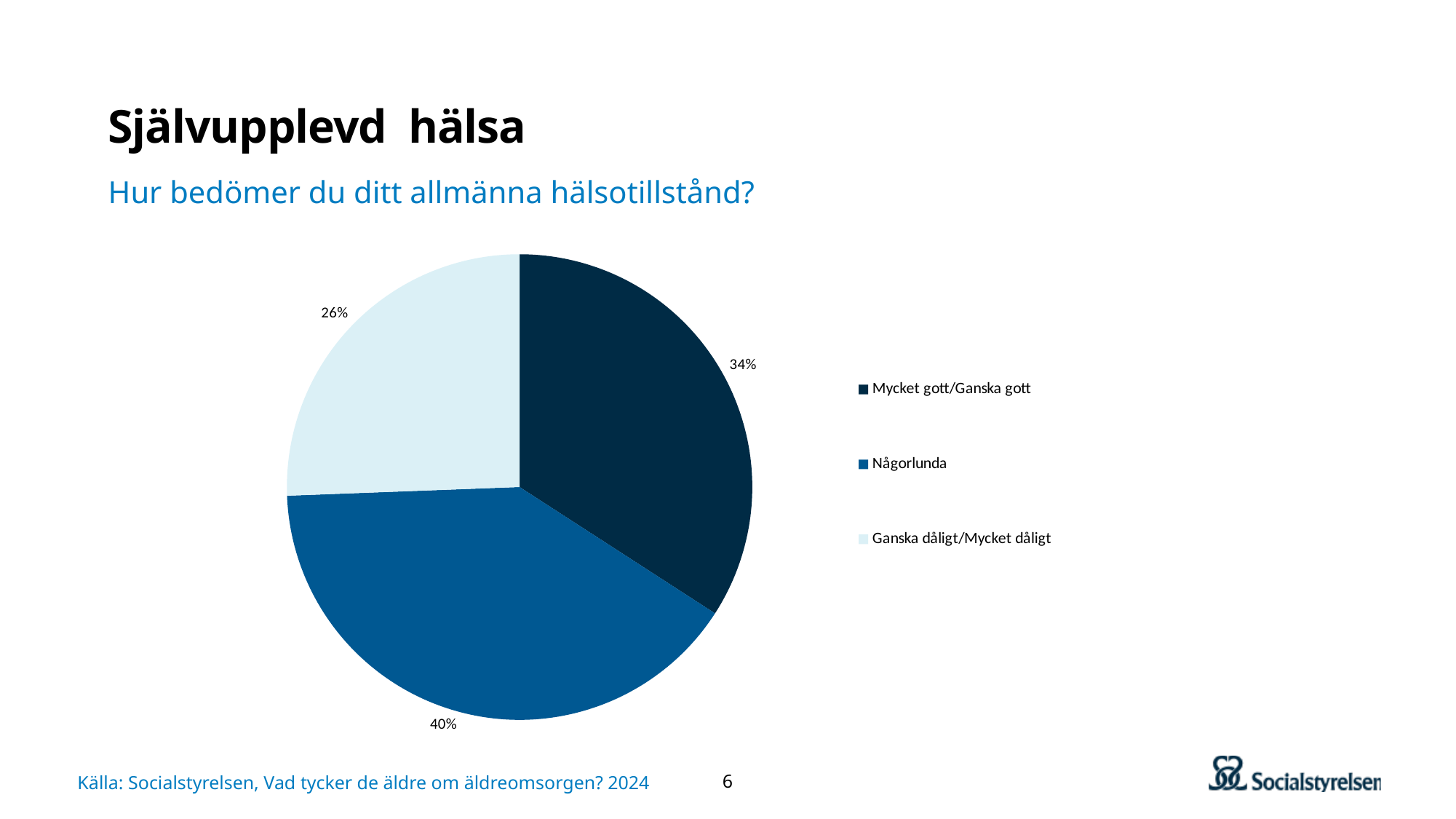
What share of the pie is labelled for Ganska dåligt/Mycket dåligt? 26% What question is shown as the chart's subtitle? Hur bedömer du ditt allmänna hälsotillstånd? How many categories does the legend list? 3 What share of the pie is labelled for Någorlunda? 40% Which is larger, the slice for Mycket gott/Ganska gott or the slice for Ganska dåligt/Mycket dåligt? Mycket gott/Ganska gott What is the difference in percentage points between Någorlunda and Ganska dåligt/Mycket dåligt? 14 What type of chart is shown on the slide? pie chart Which category has the smallest slice of the pie? Ganska dåligt/Mycket dåligt Which category has the largest slice of the pie? Någorlunda What share of the pie is labelled for Mycket gott/Ganska gott? 34% What is the difference in percentage points between Någorlunda and Mycket gott/Ganska gott? 6 Which category is shown in the lightest colour in the legend? Ganska dåligt/Mycket dåligt